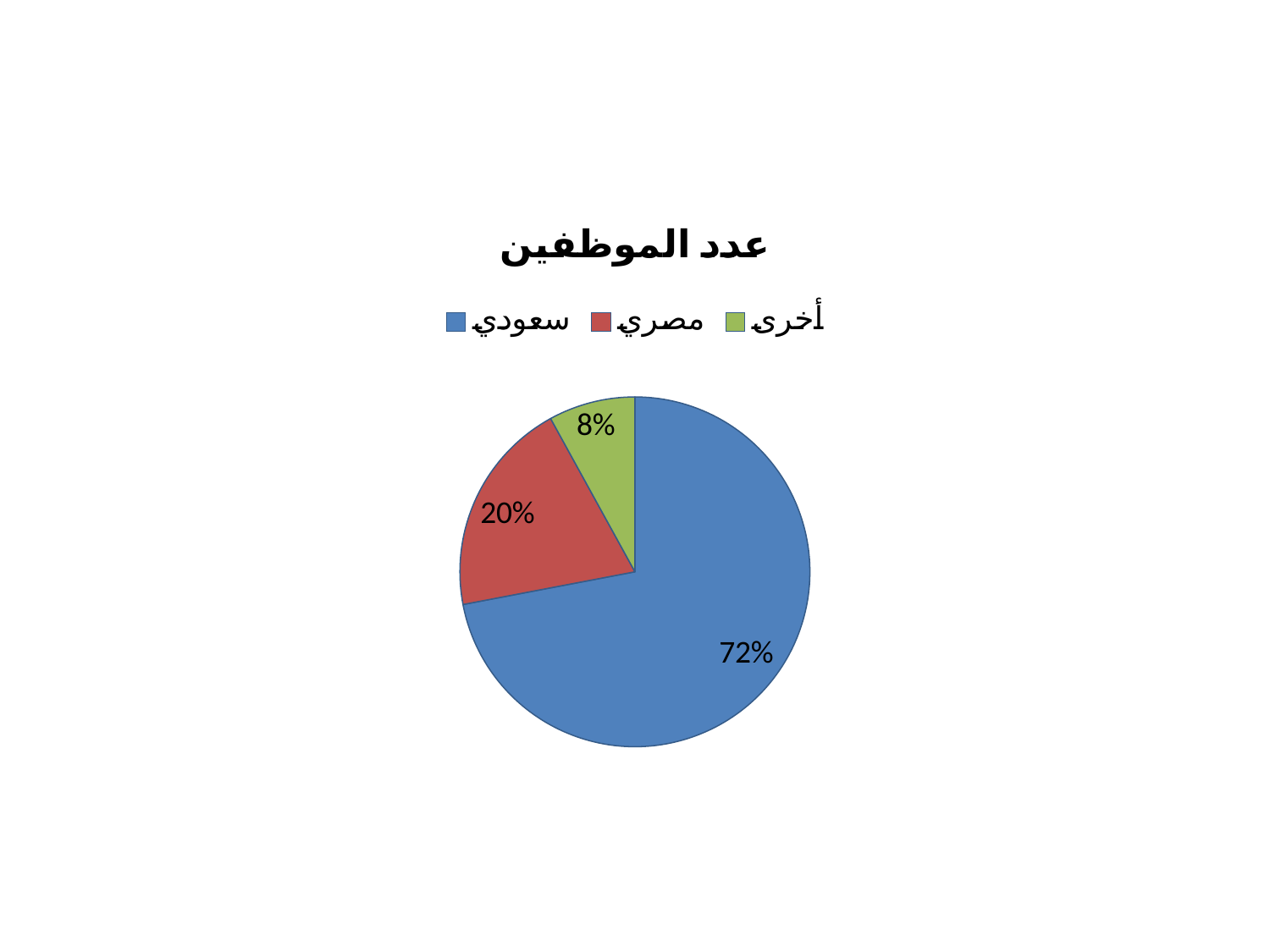
How many slices does the pie chart have? 3 What share of the pie does سعودي represent? 72% What colour is the slice for سعودي? blue What is the difference in percentage points between the مصري and أخرى slices? 12 What is the difference in percentage points between the سعودي and مصري slices? 52 Which category has the largest slice of the pie? سعودي What share of the pie does مصري represent? 20% Which category has the smallest slice of the pie? أخرى What is the title of the chart? عدد الموظفين What share of the pie does أخرى represent? 8% What kind of chart is shown on the slide? pie chart Which is larger, the slice for مصري or the slice for أخرى? مصري